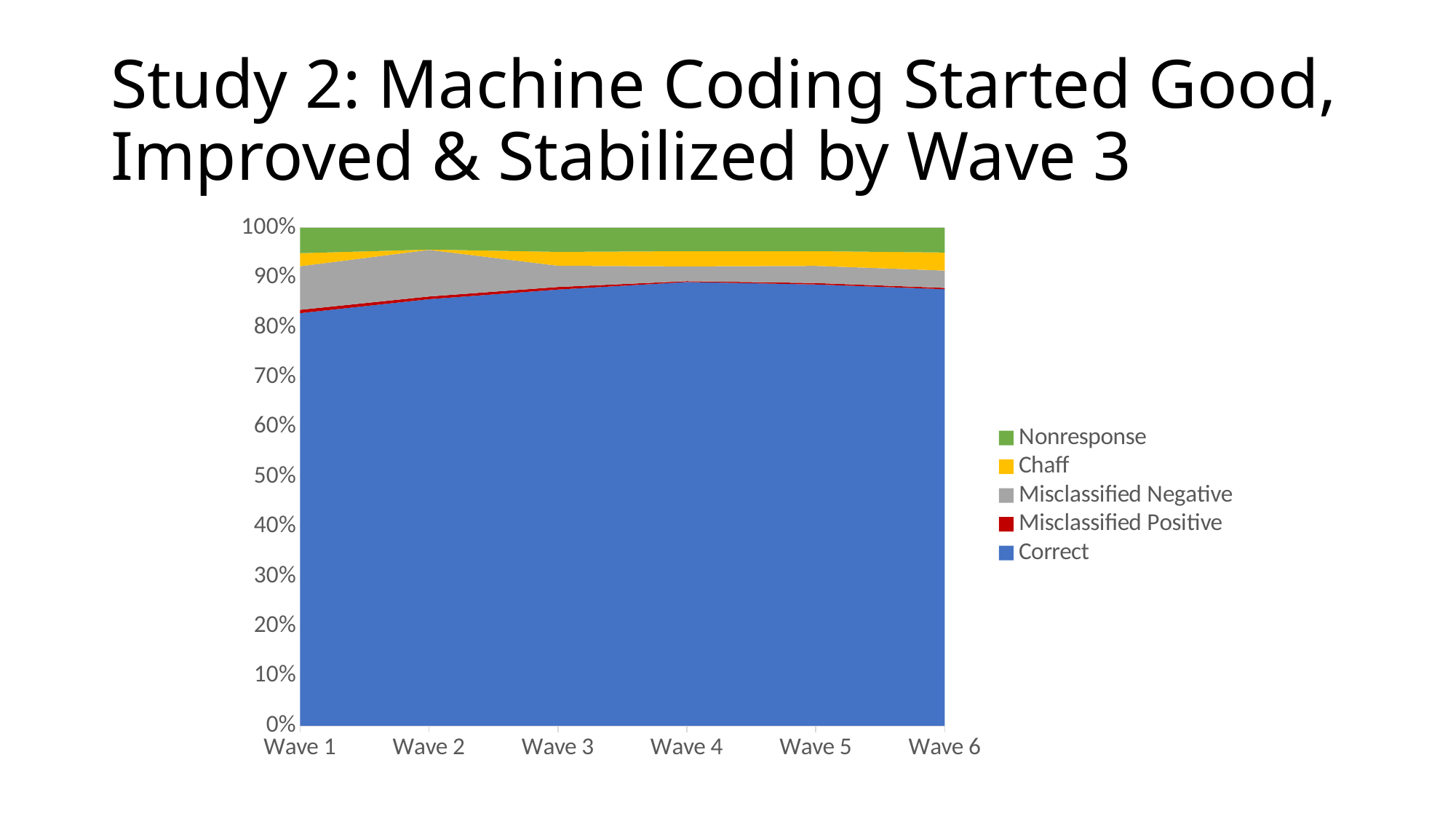
How many series does the legend list? 5 How many waves are shown along the x axis? 6 At which wave is the Correct share lowest? Wave 1 Is the value for Correct at Wave 6 greater or less than 90%? less Does the Correct share rise or fall from Wave 1 to Wave 4? Rise Is the value for Correct at Wave 4 greater or less than 80%? greater What kind of chart is shown on the slide? Stacked area chart Which series is listed first in the legend? Nonresponse Is the value for Correct at Wave 1 greater or less than 90%? less Which series is shown in blue? Correct Which is larger, the Correct share at Wave 1 or at Wave 3? Wave 3